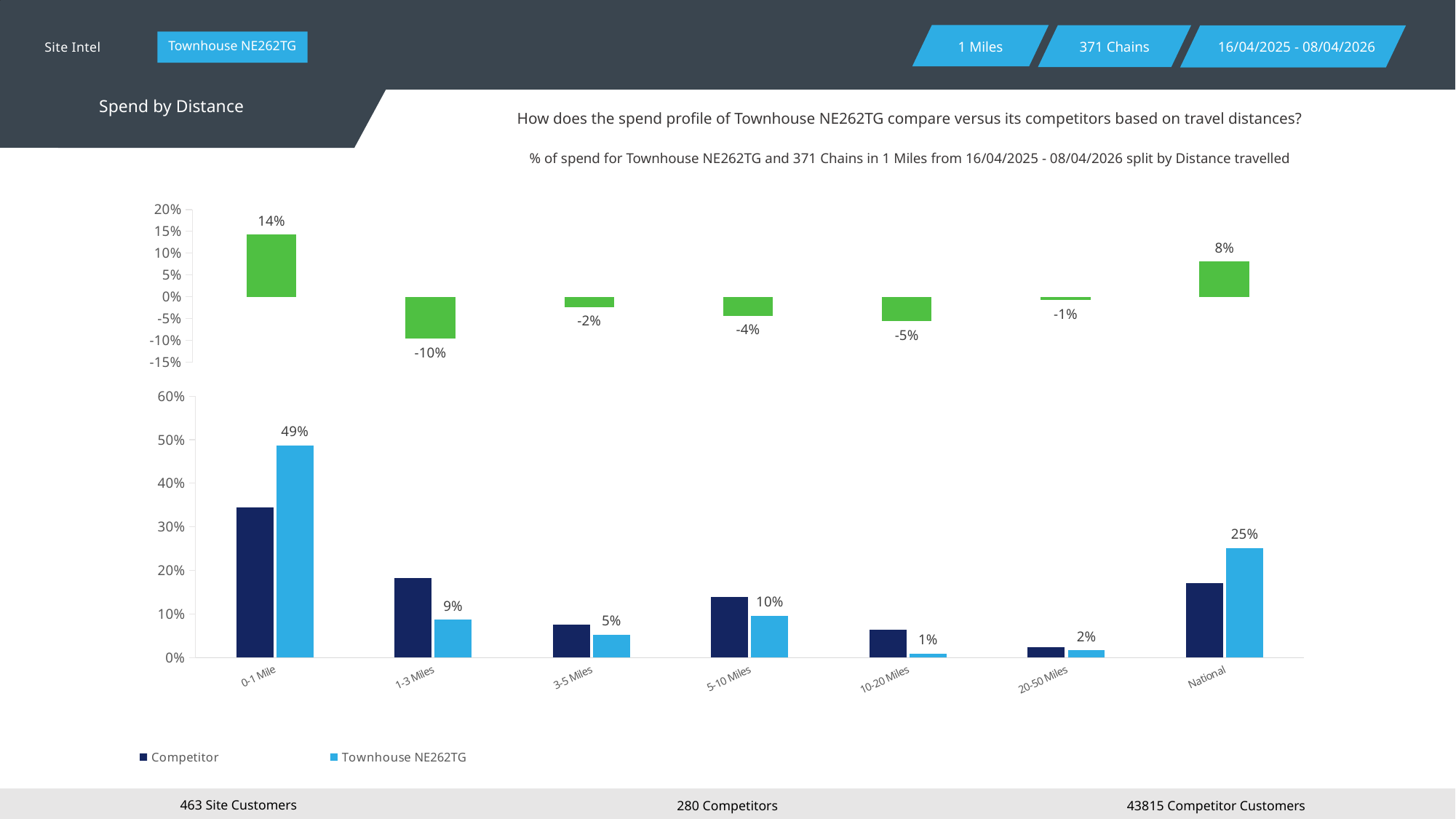
In the top chart, which category has the highest value? 0-1 Mile In the bottom chart, what is the value for Townhouse NE262TG in the National category? 25% In the bottom chart, which is larger for 1-3 Miles: the Competitor bar or the Townhouse NE262TG bar? Competitor In the bottom chart, which category has the lowest value for Townhouse NE262TG? 10-20 Miles In the bottom chart, what is the difference between the Townhouse NE262TG values for 0-1 Mile and National? 24% In the bottom chart, what is the value for Townhouse NE262TG in the 5-10 Miles category? 10% How many categories are shown on the x axis of the bottom chart? 7 In the bottom chart, which category has the highest value for Townhouse NE262TG? 0-1 Mile In the bottom chart, is the Competitor value for 0-1 Mile greater or less than 30%? greater In the bottom chart, what is the value for Townhouse NE262TG in the 0-1 Mile category? 49% How many series does the legend of the bottom chart list? 2 In the top chart, what is the value for the 1-3 Miles category? -10%